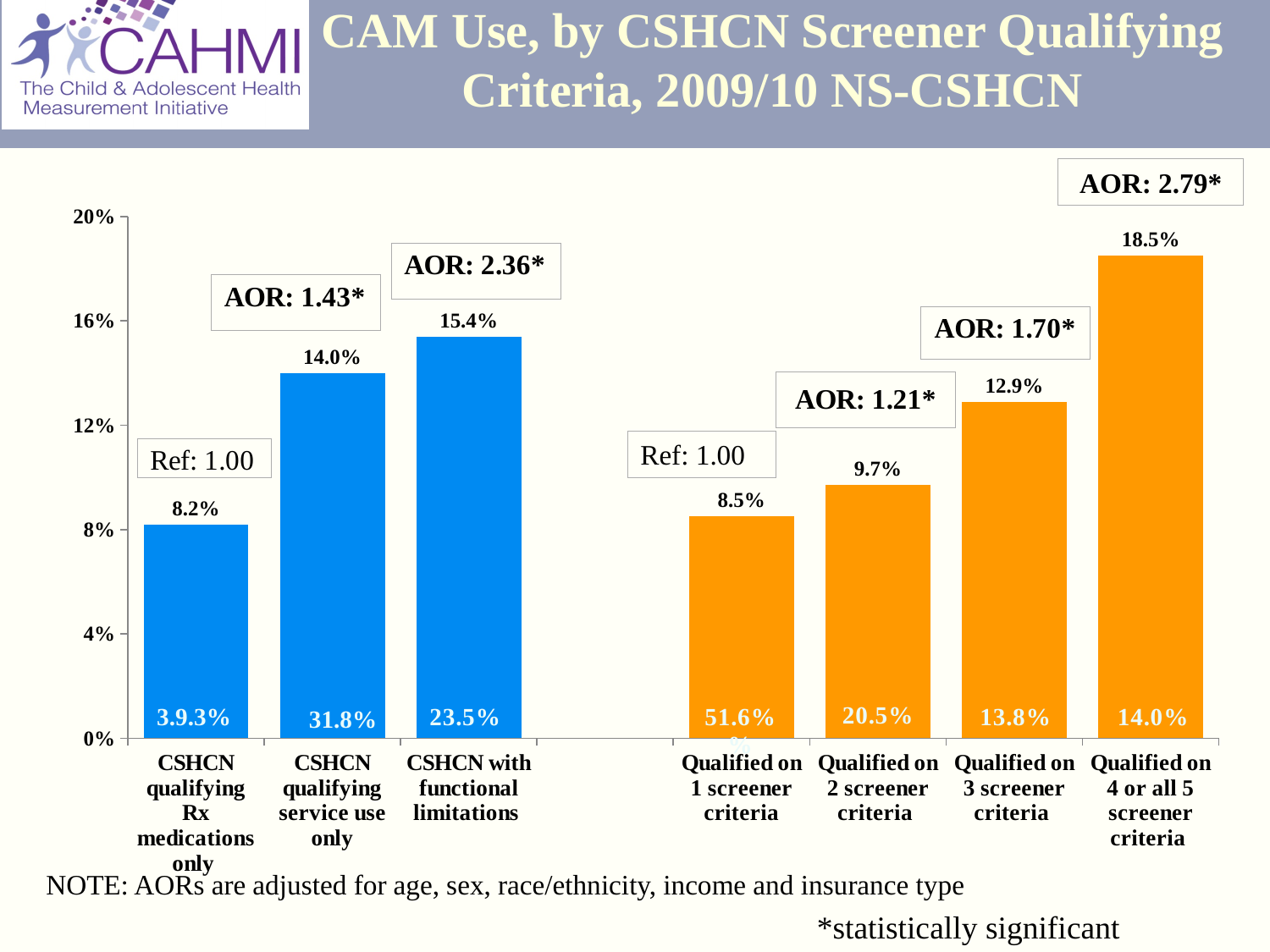
What is the CAM use value for CSHCN qualifying service use only? 14.0% Which category has the highest CAM use value? Qualified on 4 or all 5 screener criteria Which category has the lowest CAM use value? CSHCN qualifying Rx medications only Do the CAM use values rise or fall from Qualified on 1 screener criteria to Qualified on 4 or all 5 screener criteria? Rise What AOR is shown above the bar for Qualified on 3 screener criteria? AOR: 1.70* What is the CAM use value for Qualified on 2 screener criteria? 9.7% Which has a higher CAM use value: CSHCN qualifying service use only or Qualified on 3 screener criteria? CSHCN qualifying service use only What is the CAM use value for Qualified on 4 or all 5 screener criteria? 18.5% What kind of chart is shown on the slide? Bar chart How many categories are shown on the x axis? 7 What is the CAM use value for CSHCN with functional limitations? 15.4% What is the difference between the CAM use values for Qualified on 4 or all 5 screener criteria and Qualified on 1 screener criteria? 10.0%